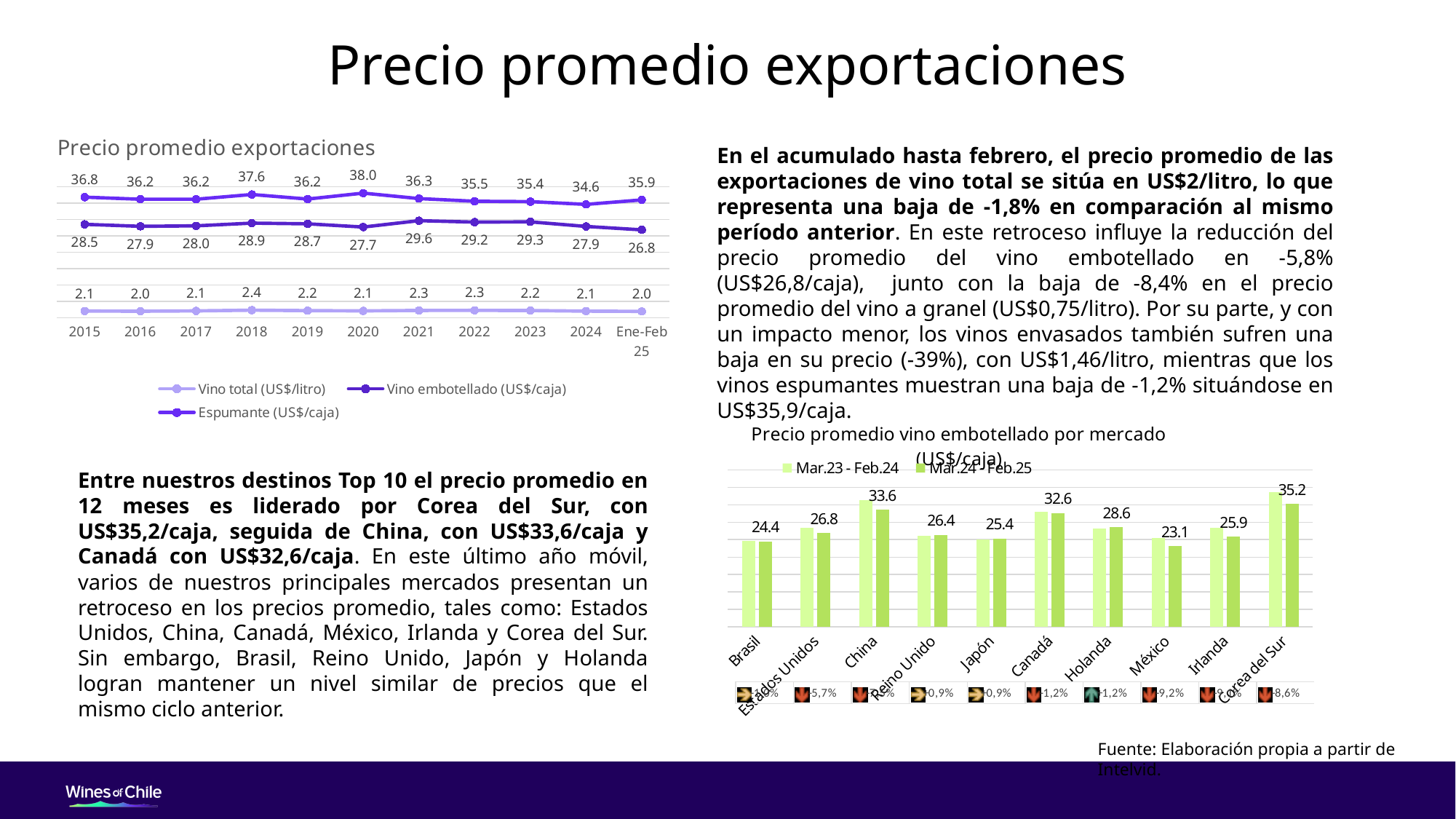
In the chart titled 'Precio promedio exportaciones', what kind of chart is used? Line chart In the chart titled 'Precio promedio exportaciones', how many periods are shown on the x axis? 11 In the chart titled 'Precio promedio vino embotellado por mercado (US$/caja)', what value is labelled for China? 33.6 In the chart titled 'Precio promedio exportaciones', how many series does the legend list? 3 In the chart titled 'Precio promedio exportaciones', what is the difference between Vino embotellado (US$/caja) in 2021 and in Ene-Feb 25? 2.8 In the chart titled 'Precio promedio vino embotellado por mercado (US$/caja)', how many series does the legend list? 2 In the chart titled 'Precio promedio exportaciones', what is the value of Vino embotellado (US$/caja) for Ene-Feb 25? 26.8 In the chart titled 'Precio promedio exportaciones', in which year is Espumante (US$/caja) highest? 2020 In the chart titled 'Precio promedio exportaciones', what is the value of Vino total (US$/litro) in 2018? 2.4 In the chart titled 'Precio promedio exportaciones', what is the value of Espumante (US$/caja) in 2020? 38.0 In the chart titled 'Precio promedio vino embotellado por mercado (US$/caja)', what kind of chart is used? Bar chart In the chart titled 'Precio promedio vino embotellado por mercado (US$/caja)', which market has the highest labelled value? Corea del Sur